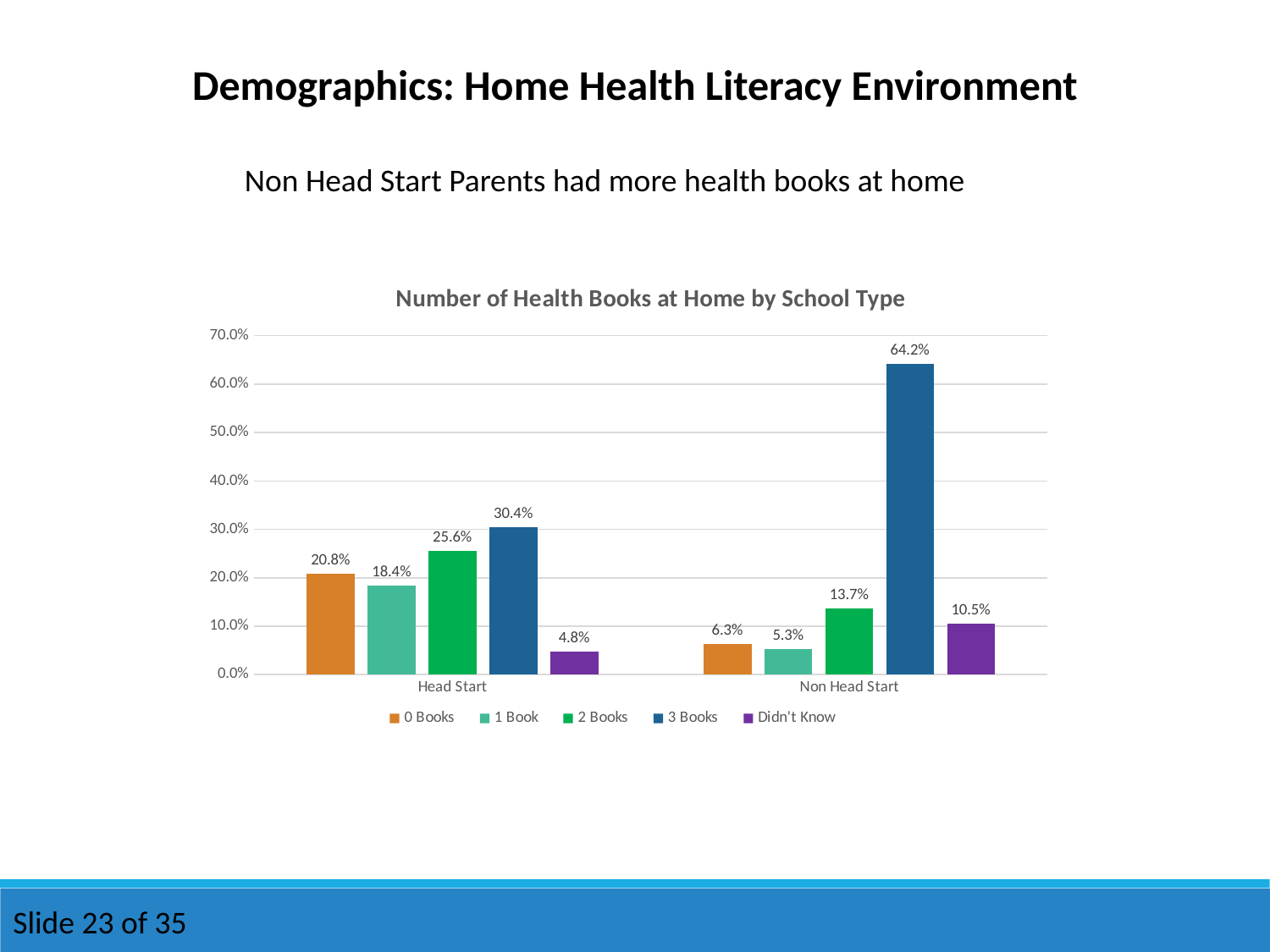
What kind of chart is shown on the slide? Bar chart What is the value for Didn't Know in the Non Head Start group? 10.5% What is the title of the chart? Number of Health Books at Home by School Type What is the value for 3 Books in the Non Head Start group? 64.2% Which series has the highest value in the Head Start group? 3 Books What is the value for 0 Books in the Head Start group? 20.8% Is the value for 1 Book in the Head Start group greater or less than 20.0%? less How many series does the legend list? 5 Which series has the lowest value in the Non Head Start group? 1 Book How many school type categories are shown on the x axis? 2 What is the difference between the 3 Books values for Non Head Start and Head Start? 33.8% Which is larger: the 2 Books value for Head Start or the 2 Books value for Non Head Start? Head Start